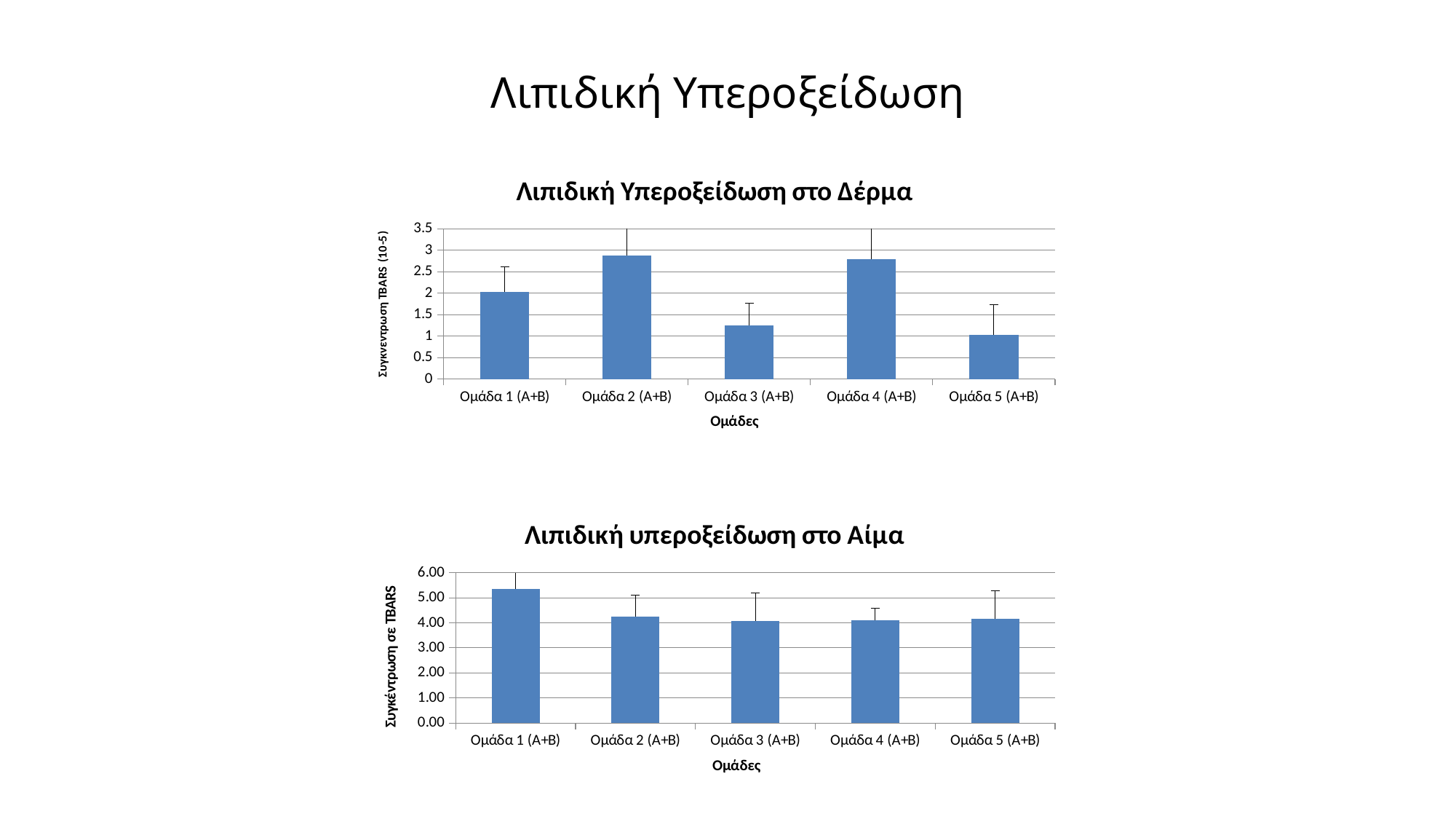
How many groups (categories) are shown on the x axis of the "Λιπιδική Υπεροξείδωση στο Δέρμα" chart? 5 What type of chart is "Λιπιδική Υπεροξείδωση στο Δέρμα"? bar chart In the "Λιπιδική υπεροξείδωση στο Αίμα" chart, which is larger, the value for Ομάδα 1 (A+B) or Ομάδα 2 (A+B)? Ομάδα 1 (A+B) In the "Λιπιδική υπεροξείδωση στο Αίμα" chart, which group has the highest value? Ομάδα 1 (A+B) What is the x-axis title of the "Λιπιδική υπεροξείδωση στο Αίμα" chart? Ομάδες In the "Λιπιδική Υπεροξείδωση στο Δέρμα" chart, is the value for Ομάδα 3 (A+B) greater or less than 1.5? less What is the y-axis title of the "Λιπιδική υπεροξείδωση στο Αίμα" chart? Συγκέντρωση σε TBARS In the "Λιπιδική Υπεροξείδωση στο Δέρμα" chart, is the value for Ομάδα 2 (A+B) greater or less than 2.5? greater In the "Λιπιδική υπεροξείδωση στο Αίμα" chart, is the value for Ομάδα 1 (A+B) greater or less than 5.00? greater In the "Λιπιδική Υπεροξείδωση στο Δέρμα" chart, which is larger, the value for Ομάδα 1 (A+B) or Ομάδα 3 (A+B)? Ομάδα 1 (A+B)